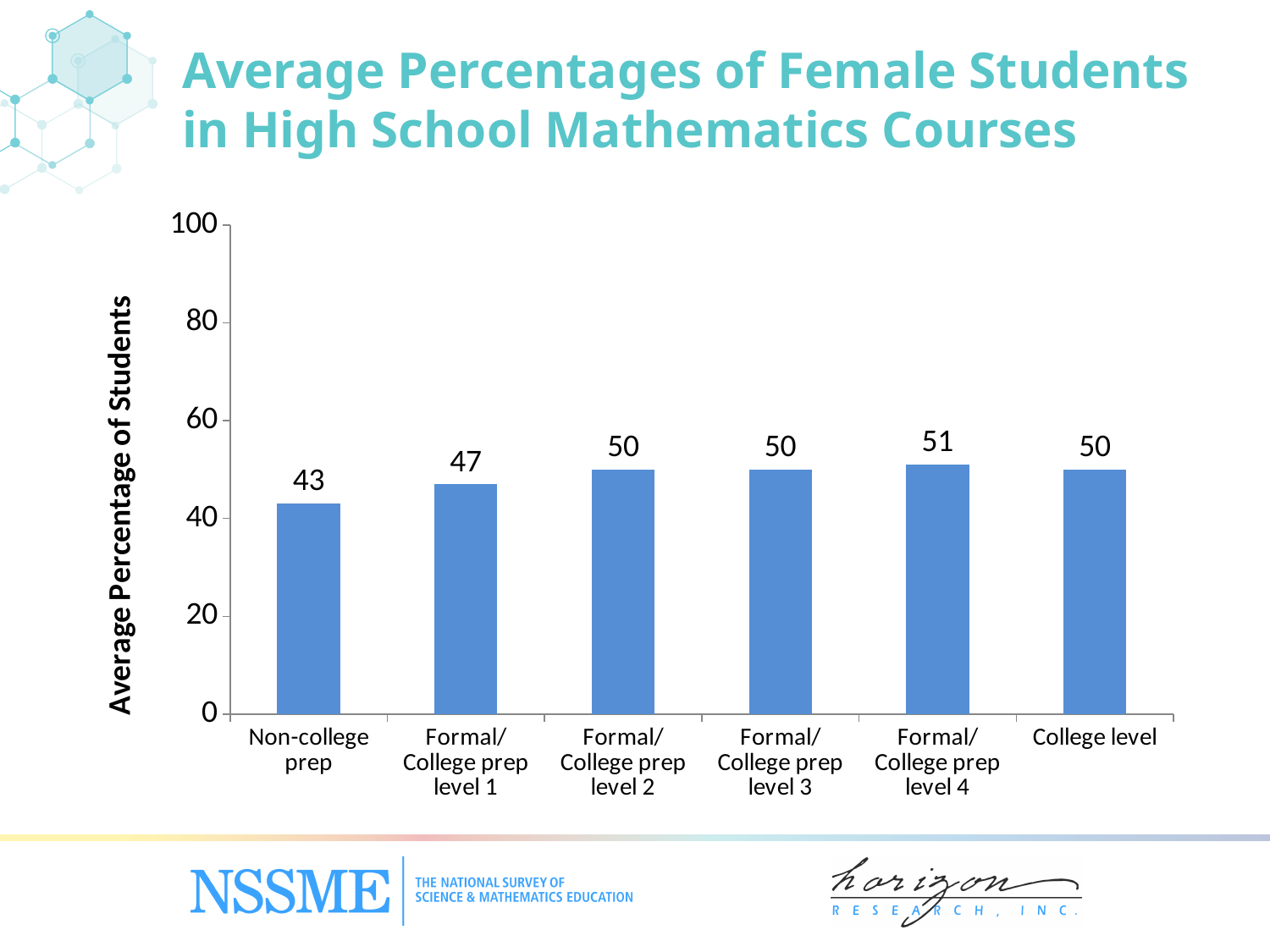
What is the value for Formal/College prep level 1? 47 Which is larger, the value for Formal/College prep level 1 or the value for Formal/College prep level 2? Formal/College prep level 2 What is the difference between the values for Formal/College prep level 4 and Non-college prep? 8 Which course category has the highest average percentage of female students? Formal/College prep level 4 What is the label of the vertical axis? Average Percentage of Students How many course categories are shown on the chart? 6 What is the value for College level? 50 What is the average percentage of female students in Non-college prep courses? 43 Is the value for Non-college prep greater or less than 40? greater Which course category has the lowest average percentage of female students? Non-college prep What is the value for Formal/College prep level 4? 51 What kind of chart is shown on the slide? Bar chart